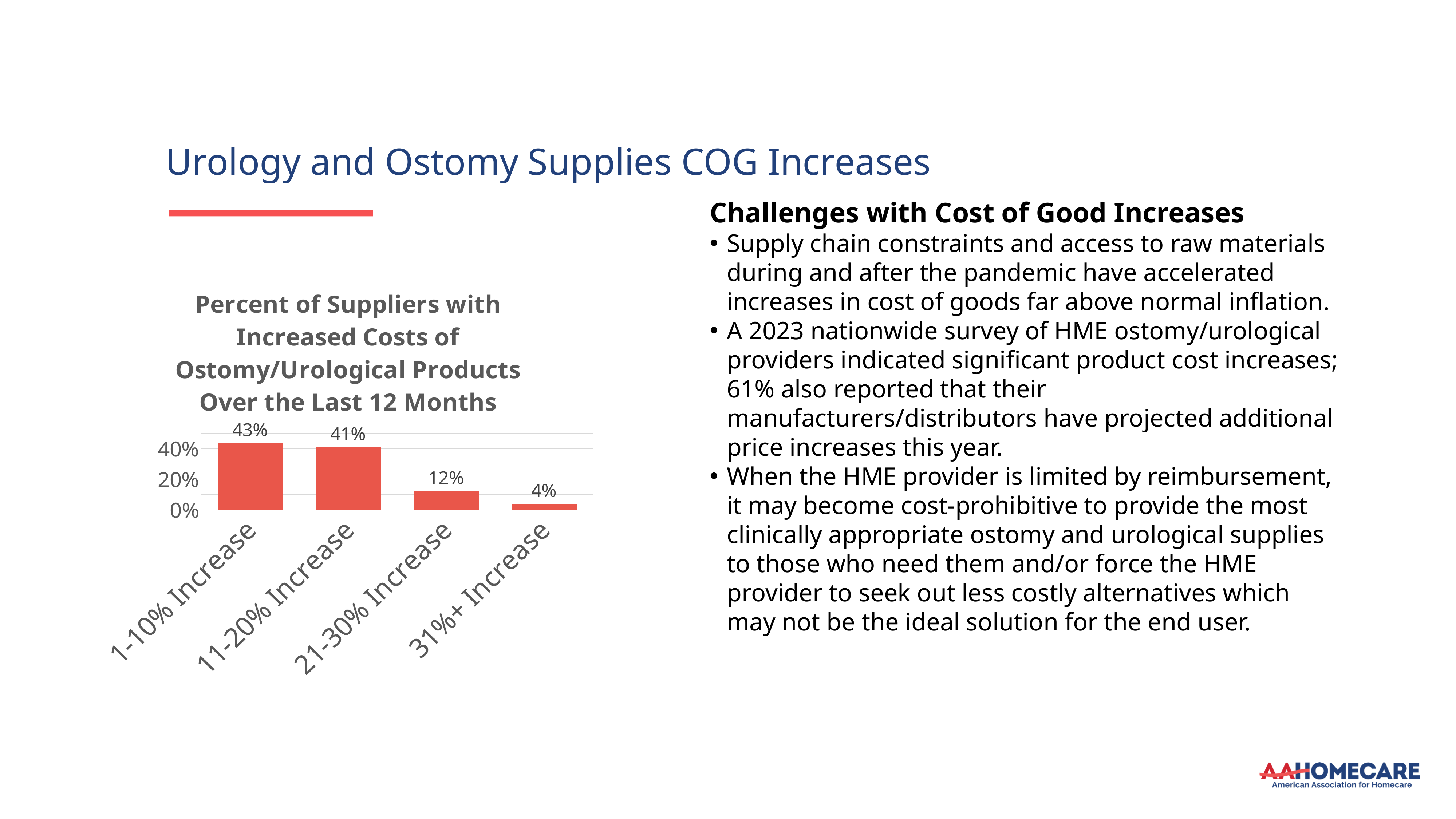
Do the values rise or fall moving from left to right across the categories? Fall What percent of suppliers reported a 31%+ increase in costs? 4% What is the difference in percentage points between the 1-10% Increase and 21-30% Increase categories? 31 Which cost increase category has the lowest percent of suppliers? 31%+ Increase How many cost increase categories are shown in the chart? 4 What kind of chart is shown on the slide? Bar chart What percent of suppliers reported a 1-10% increase in costs? 43% Which is larger: the value for 11-20% Increase or the value for 21-30% Increase? 11-20% Increase What percent of suppliers reported an 11-20% increase in costs? 41% Which cost increase category has the highest percent of suppliers? 1-10% Increase What percent of suppliers reported a 21-30% increase in costs? 12% What is the difference in percentage points between the 21-30% Increase and 31%+ Increase categories? 8